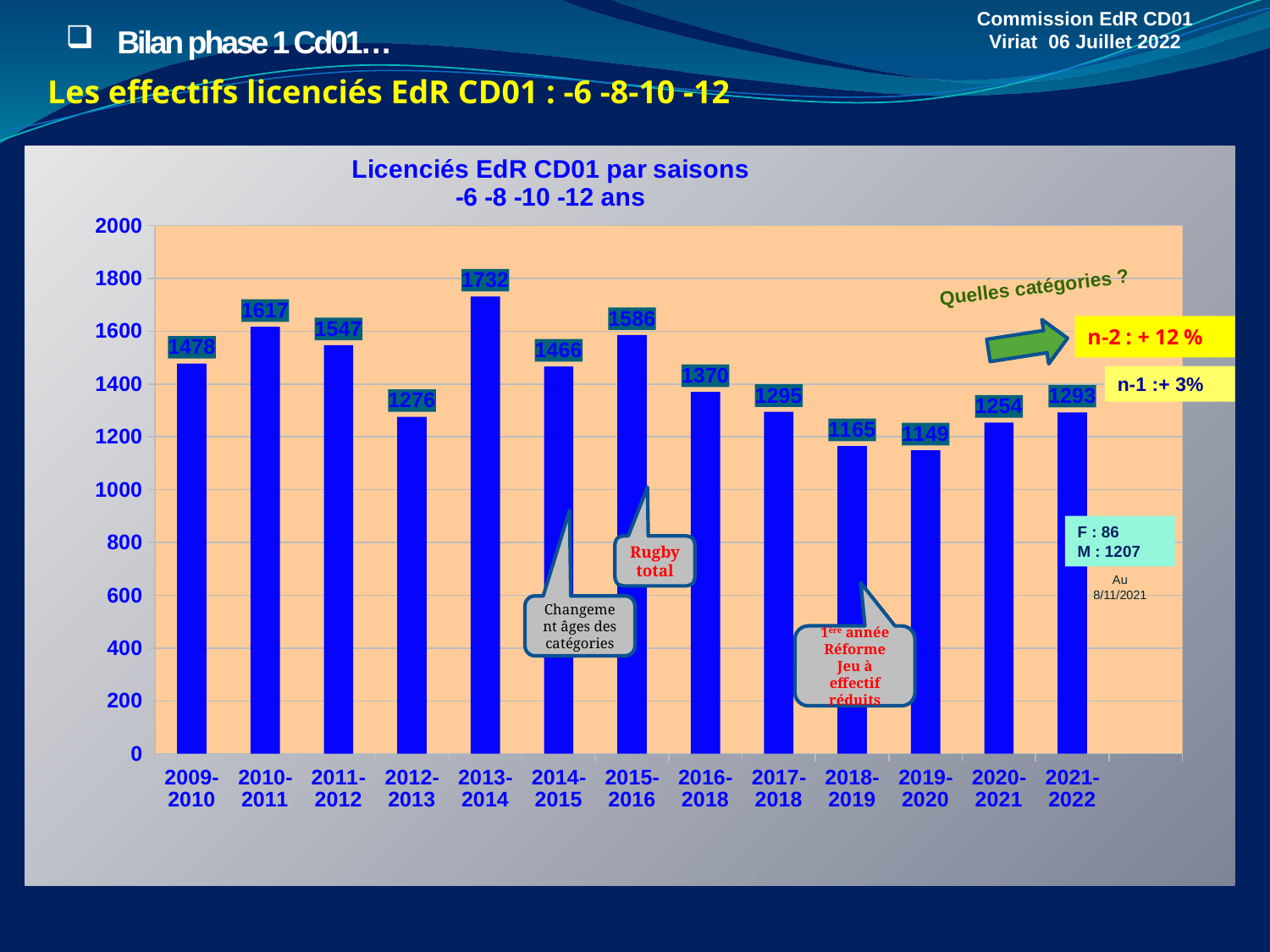
What type of chart is shown on the slide? bar chart Which season has the highest number of licenciés? 2013-2014 How many seasons are shown on the x axis? 13 Which is larger, the value for 2010-2011 or the value for 2011-2012? 2010-2011 What is the value for the 2013-2014 season? 1732 Is the value for 2018-2019 greater or less than 1200? less What is the difference between the values for 2013-2014 and 2012-2013? 456 What is the value for the 2021-2022 season? 1293 What is the title of the chart? Licenciés EdR CD01 par saisons -6 -8 -10 -12 ans What is the value for the 2019-2020 season? 1149 What is the difference between the values for 2021-2022 and 2020-2021? 39 Which season has the lowest number of licenciés? 2019-2020